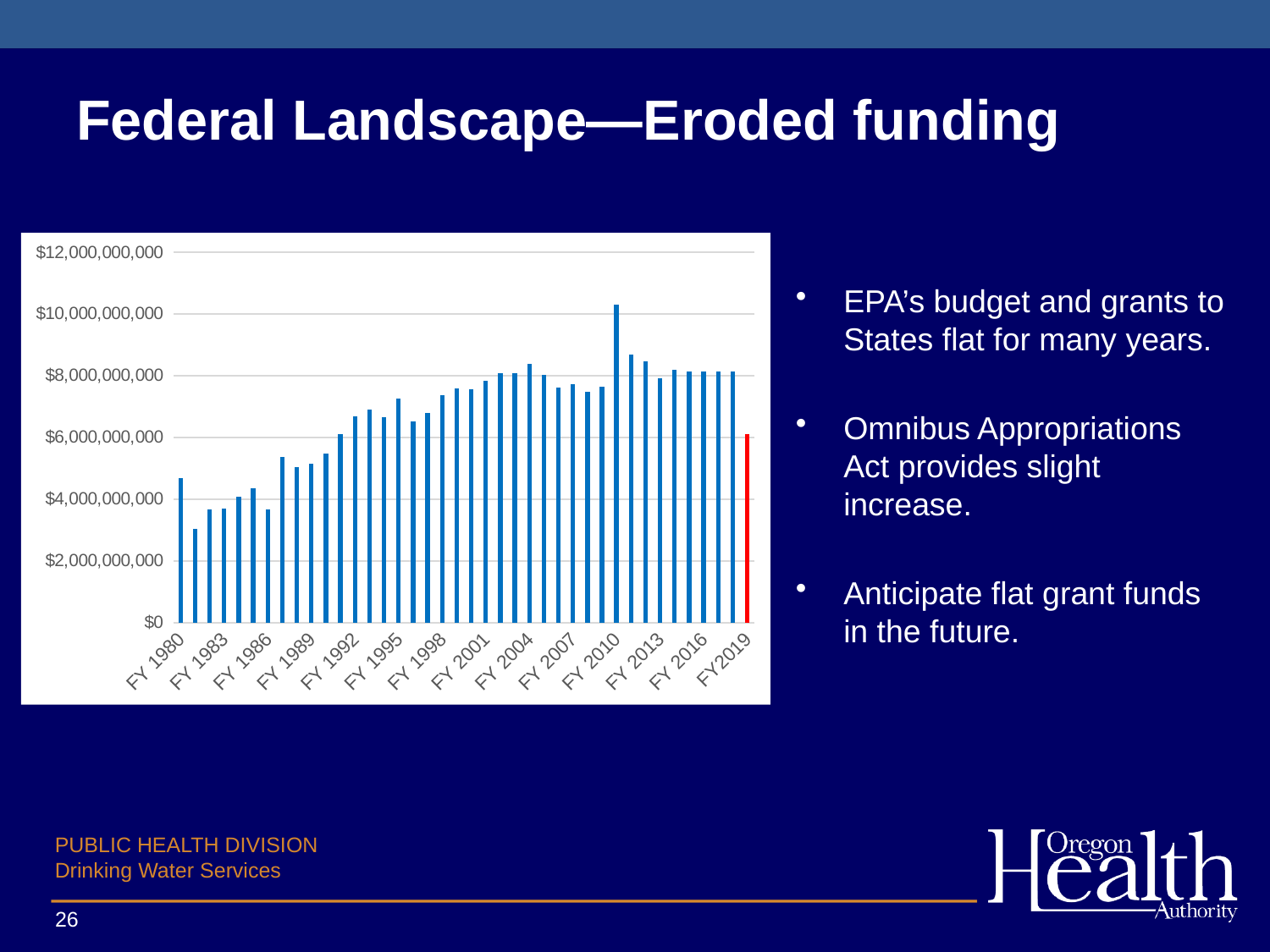
Is the value for FY 1980 greater or less than $4,000,000,000? greater Which is larger, the value for FY 2010 or the value for FY 2019? FY 2010 Do the values generally rise or fall from FY 1980 to FY 2010? rise Is the value for FY 2004 greater or less than $8,000,000,000? greater Is the value for FY 2010 greater or less than $10,000,000,000? greater Which fiscal year has the highest bar in the chart? FY 2010 What kind of chart is shown on the slide? bar chart Which fiscal year's bar is shown in red rather than blue? FY 2019